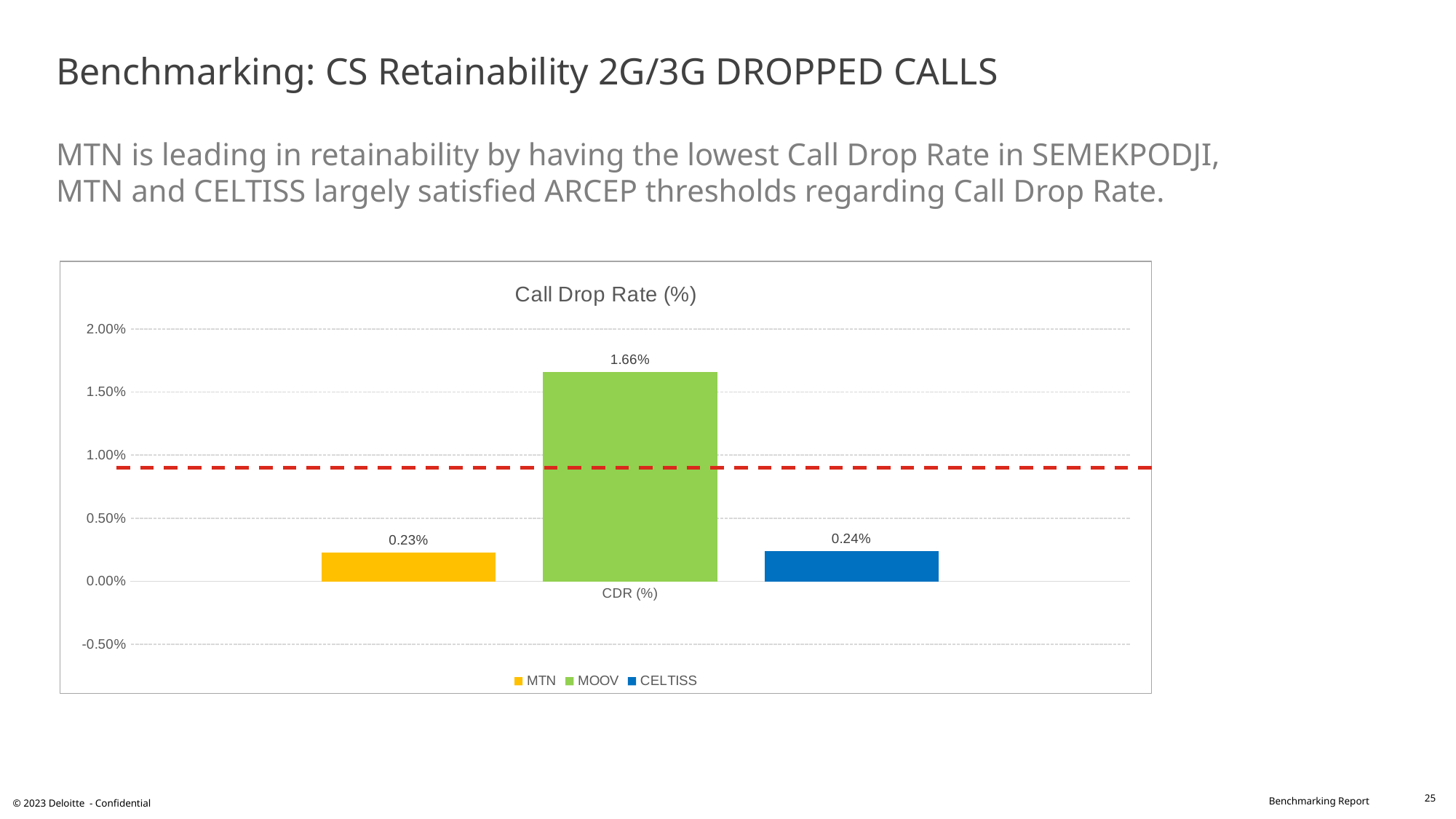
What is the difference between the Call Drop Rate of MOOV and CELTISS? 1.42% What is the title of the chart? Call Drop Rate (%) What is the Call Drop Rate for MOOV? 1.66% What is the Call Drop Rate for CELTISS? 0.24% Which operator has the lowest Call Drop Rate according to the data labels? MTN Which operator has the highest Call Drop Rate? MOOV Which has a larger Call Drop Rate, MOOV or CELTISS? MOOV What kind of chart is shown on the slide? Bar chart How many series does the legend list? 3 Is the Call Drop Rate for MOOV greater or less than 1.50%? greater What is the Call Drop Rate for MTN? 0.23% What is the difference between the Call Drop Rate of MOOV and MTN? 1.43%